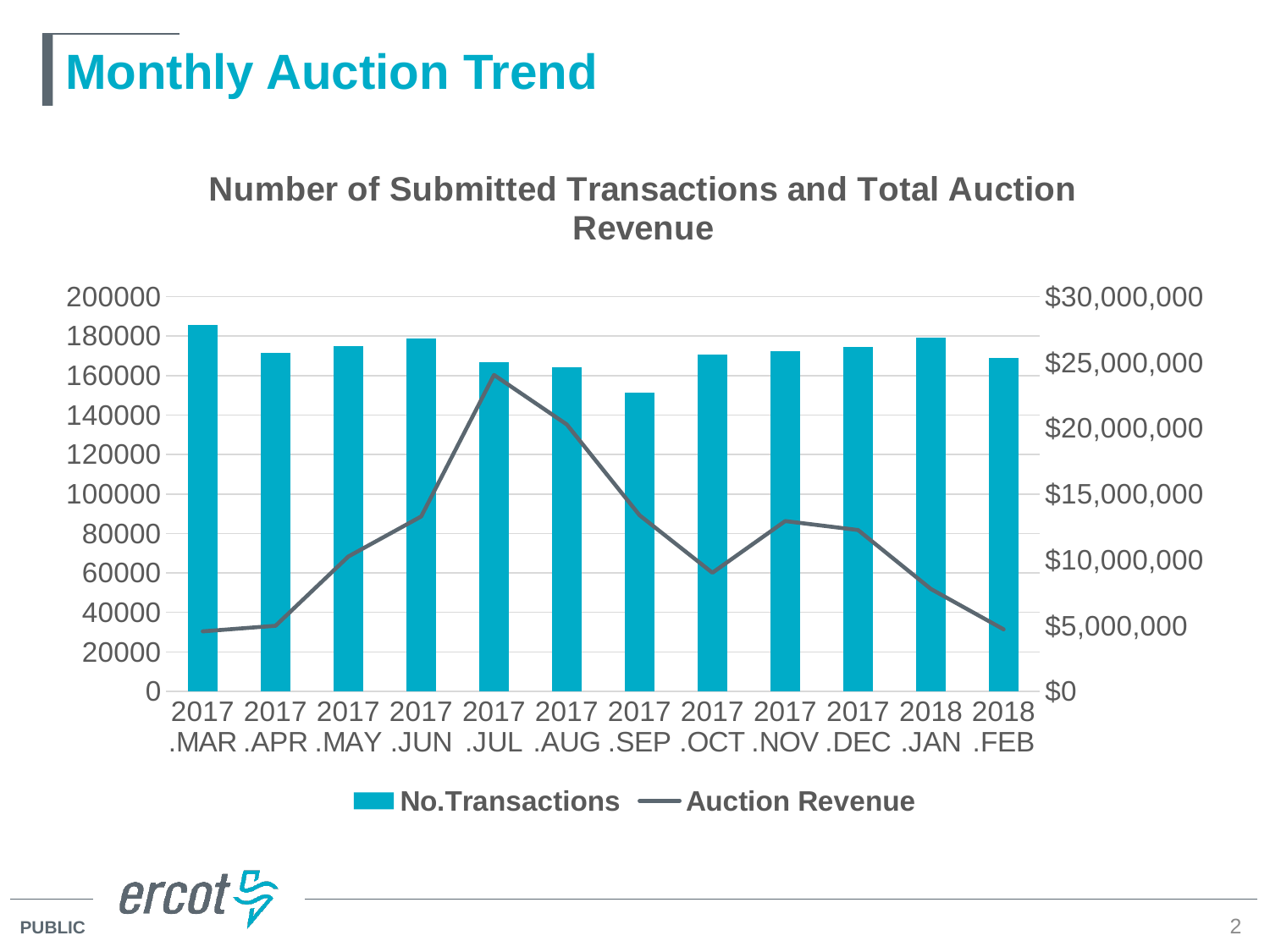
Which has the larger auction revenue, 2017.JUL or 2017.MAR? 2017.JUL Is the number of transactions for 2017.SEP greater or less than 160000? less Which month has the highest auction revenue? 2017.JUL Which month has the lowest number of transactions? 2017.SEP How many months are shown on the x axis? 12 How many series does the legend list? 2 What kind of chart is shown on the slide? A combination bar and line chart Is the auction revenue for 2017.JUN greater or less than $15,000,000? less What is the title of the chart? Number of Submitted Transactions and Total Auction Revenue Which month has the highest number of transactions? 2017.MAR Is the auction revenue for 2017.JUL greater or less than $20,000,000? greater Does the auction revenue rise or fall from 2017.MAR to 2017.JUL? rise